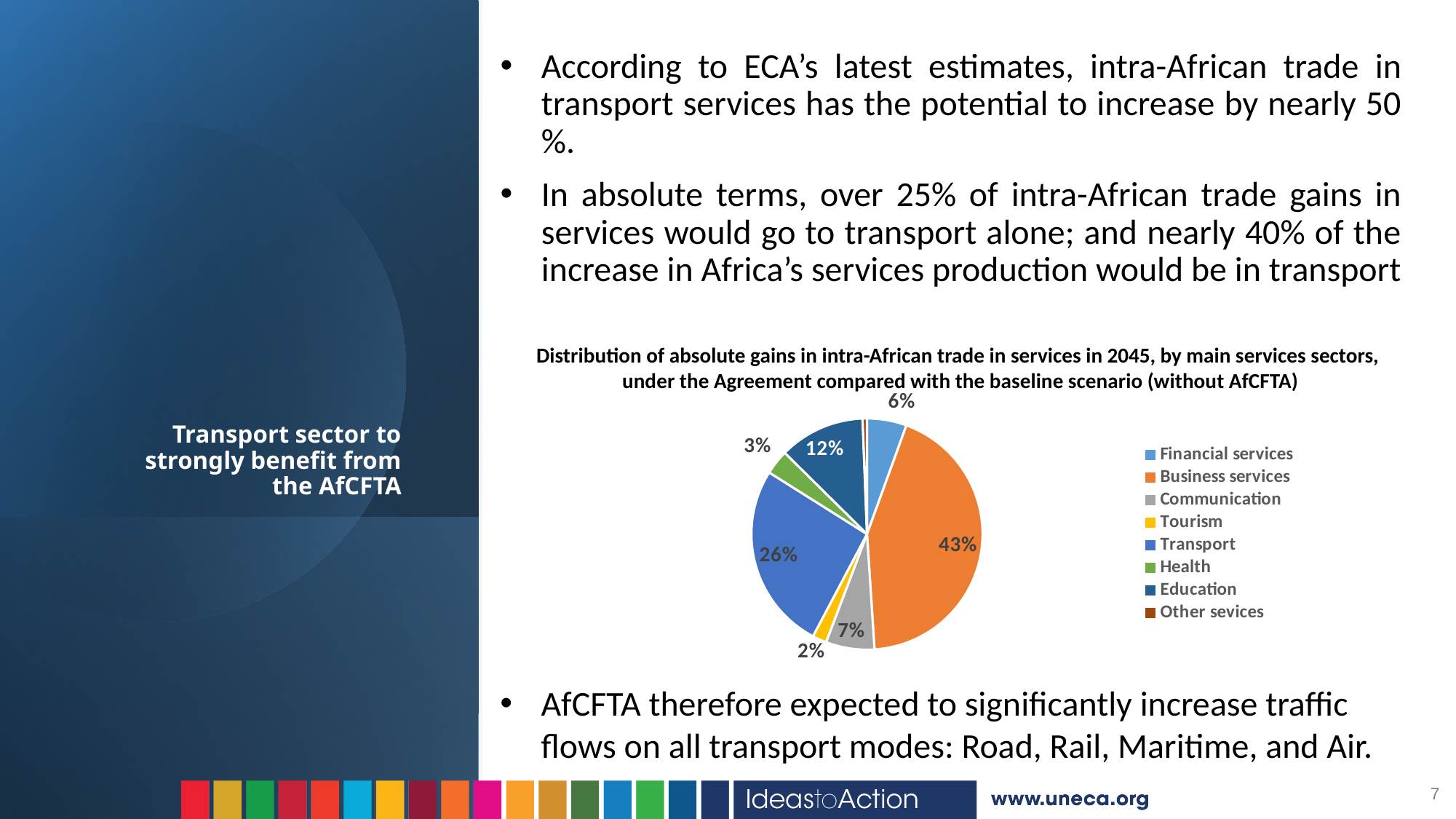
What share of the absolute gains in intra-African trade in services in 2045 goes to Business services? 43% Which has a larger share of the pie, Education or Health? Education Which sector has the largest share of the pie? Business services What colour is the Transport slice in the pie chart? blue What is the difference in percentage points between the Business services share and the Transport share? 17 What percentage is shown for Education in the pie chart? 12% What share of the pie does Transport account for? 26% What percentage is shown for Financial services in the pie chart? 6% What percentage is shown for Tourism in the pie chart? 2% What percentage is shown for Communication in the pie chart? 7% What kind of chart is shown on the slide? pie chart How many sectors does the legend of the pie chart list? 8